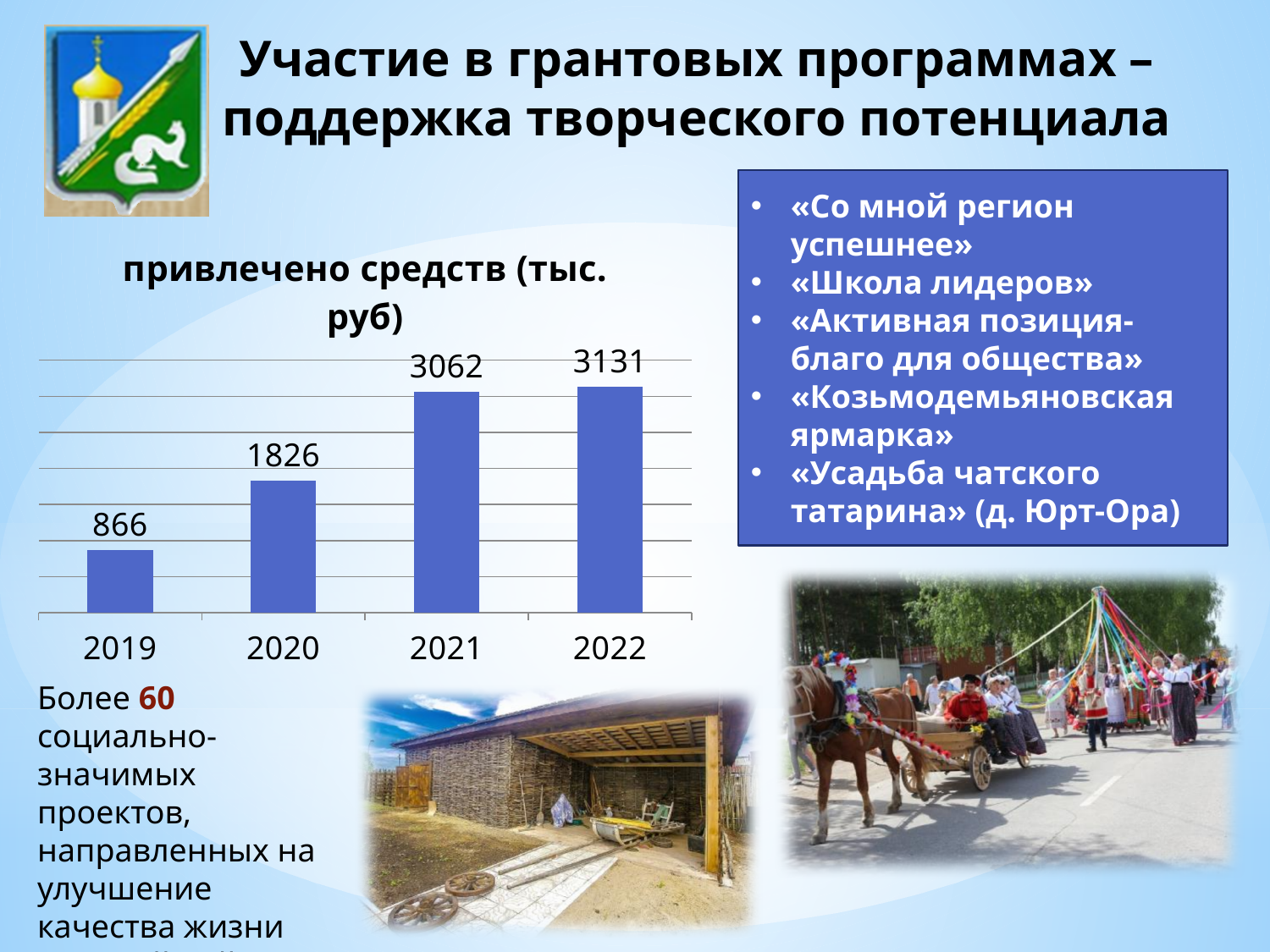
What is the value for 2021 in the chart? 3062 What is the difference between the values for 2020 and 2019? 960 Which year has the lowest value in the chart? 2019 What is the value for 2022 in the chart? 3131 What kind of chart is shown on the slide? bar chart Which year has the highest value in the chart? 2022 Do the values rise or fall from 2019 to 2022? rise What is the title of the chart? привлечено средств (тыс. руб) Which is larger, the value for 2020 or the value for 2021? 2021 How many years are shown on the x axis of the chart? 4 What is the value for 2019 in the chart 'привлечено средств (тыс. руб)'? 866 What is the difference between the values for 2022 and 2021? 69